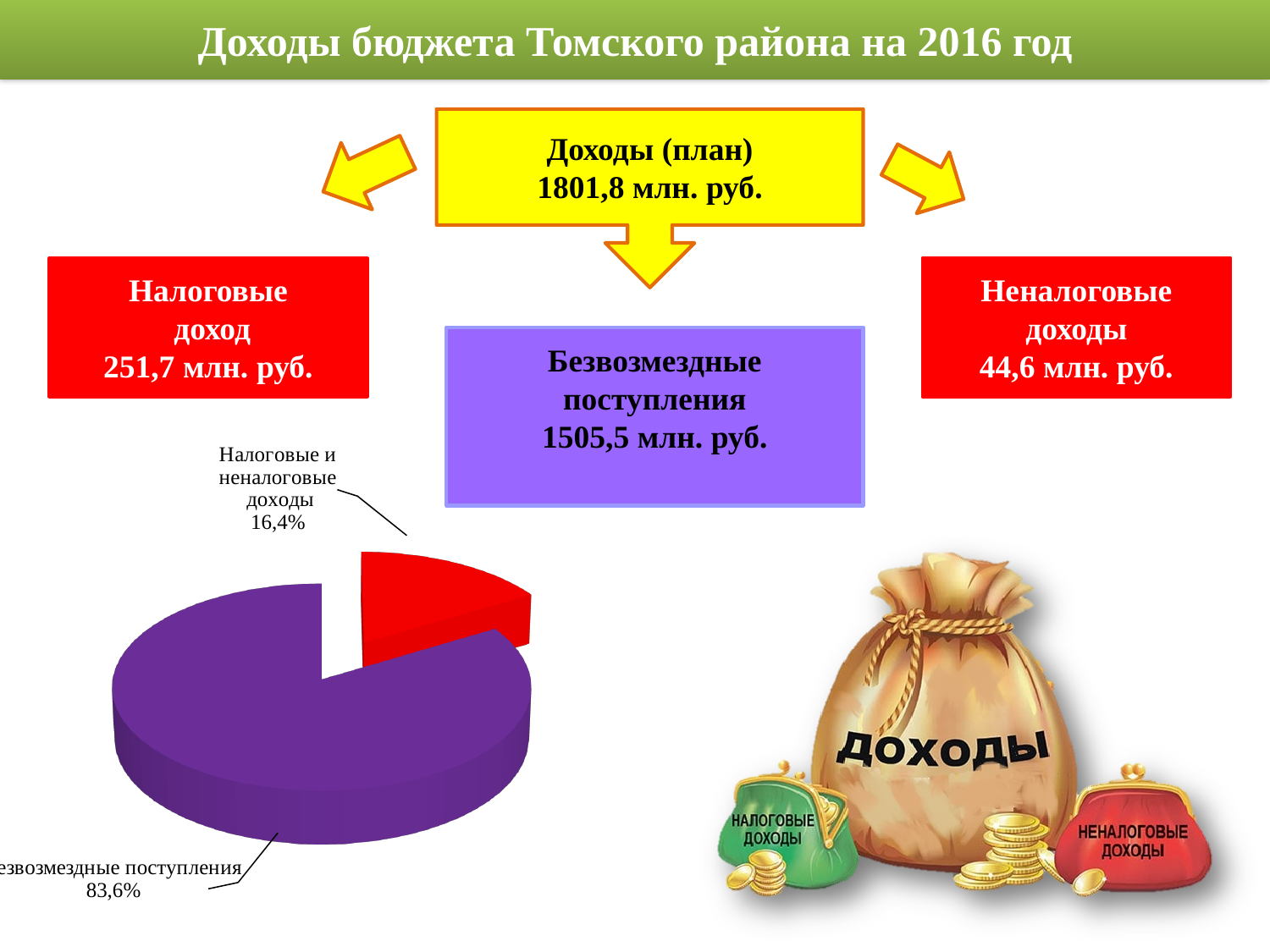
In the pie chart, which is larger: "Безвозмездные поступления" or "Налоговые и неналоговые доходы"? Безвозмездные поступления Is the share for "Налоговые и неналоговые доходы" greater or less than 50%? less What colour is the "Безвозмездные поступления" slice in the pie chart? purple By how many percentage points does the "Безвозмездные поступления" slice exceed the "Налоговые и неналоговые доходы" slice? 67,2 Which slice of the pie chart is the smallest? Налоговые и неналоговые доходы What colour is the "Налоговые и неналоговые доходы" slice in the pie chart? red What share of the pie chart is labelled "Безвозмездные поступления"? 83,6% Which slice of the pie chart is the largest? Безвозмездные поступления What share of the pie chart is labelled "Налоговые и неналоговые доходы"? 16,4% How many slices does the pie chart have? 2 What kind of chart is shown on the slide? pie chart